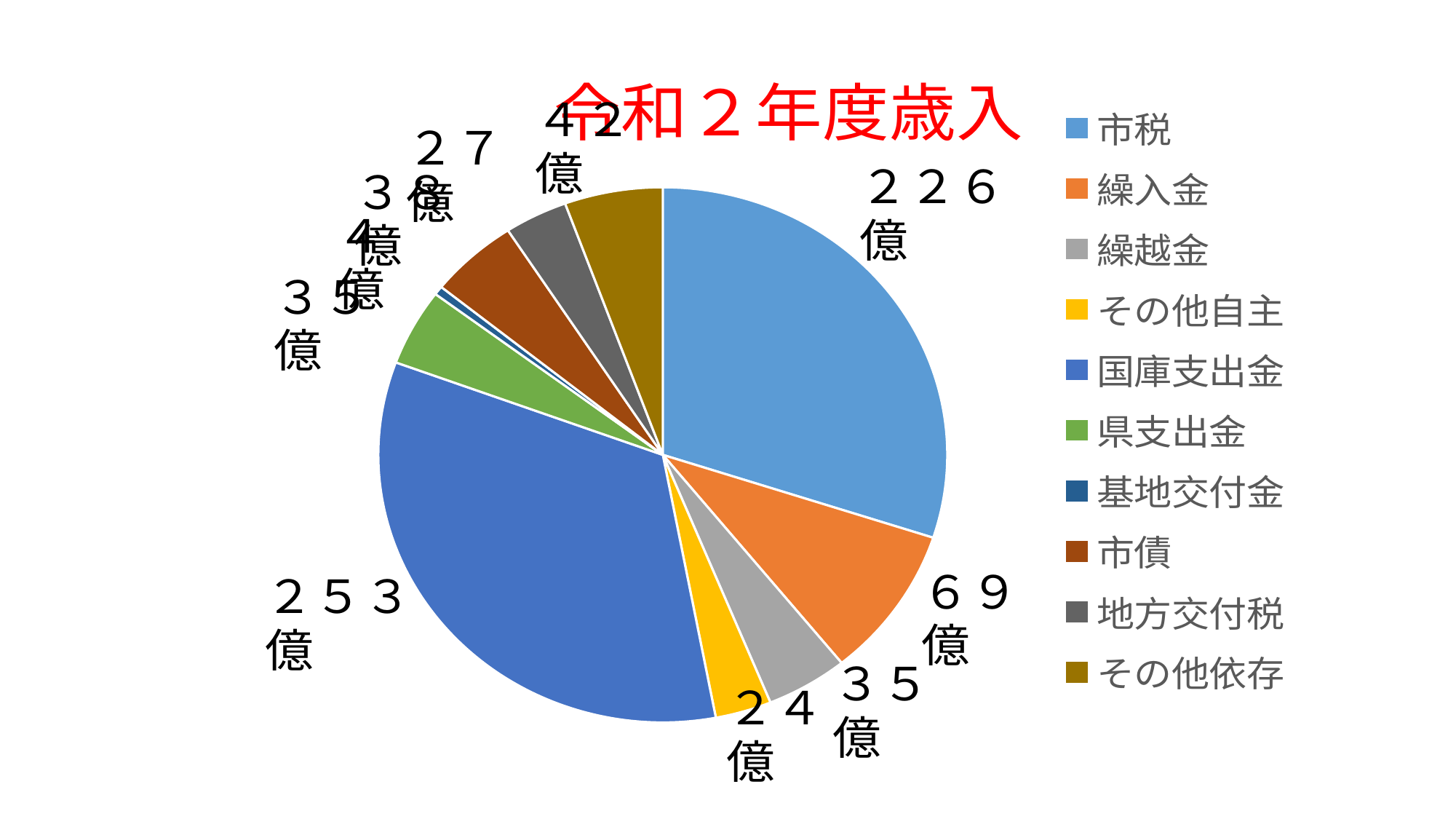
What is the title of the chart? 令和２年度歳入 What is the value shown for 繰入金? ６９億 What is the value shown for 地方交付税? ２７億 What is the value shown for 国庫支出金? ２５３億 What kind of chart is shown on the slide? pie chart How many categories does the legend of the pie chart list? 10 What is the difference between the values for 国庫支出金 and 市税? ２７億 Which is larger, 市税 or 国庫支出金? 国庫支出金 What is the value shown for 市税? ２２６億 What is the value shown for その他依存? ４２億 Which category has the largest slice of the pie? 国庫支出金 Which category has the smallest slice of the pie? 基地交付金